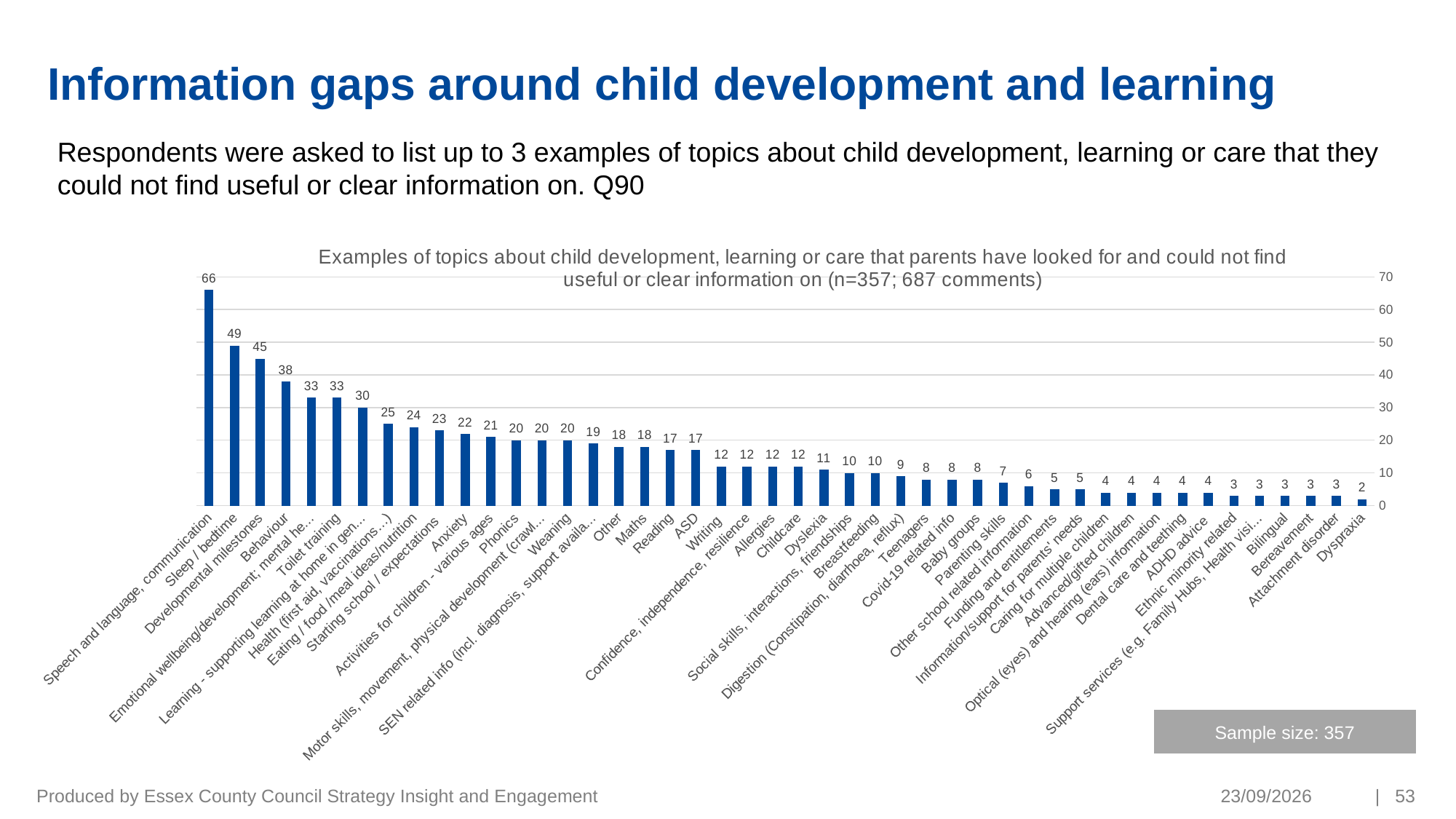
Which is larger, the value for Anxiety or the value for Breastfeeding? Anxiety What is the sample size shown on the slide? 357 What is the value for Weaning? 20 Is the value for Developmental milestones greater or less than 40? greater Which topic has the highest value? Speech and language, communication What is the value for Toilet training? 33 Which topic has the lowest value? Dyspraxia What is the difference between the values for Sleep / bedtime and Behaviour? 11 What is the value for Speech and language, communication? 66 How many topics are shown in the chart? 46 What is the value for Dyslexia? 11 What kind of chart is shown on the slide? Bar chart